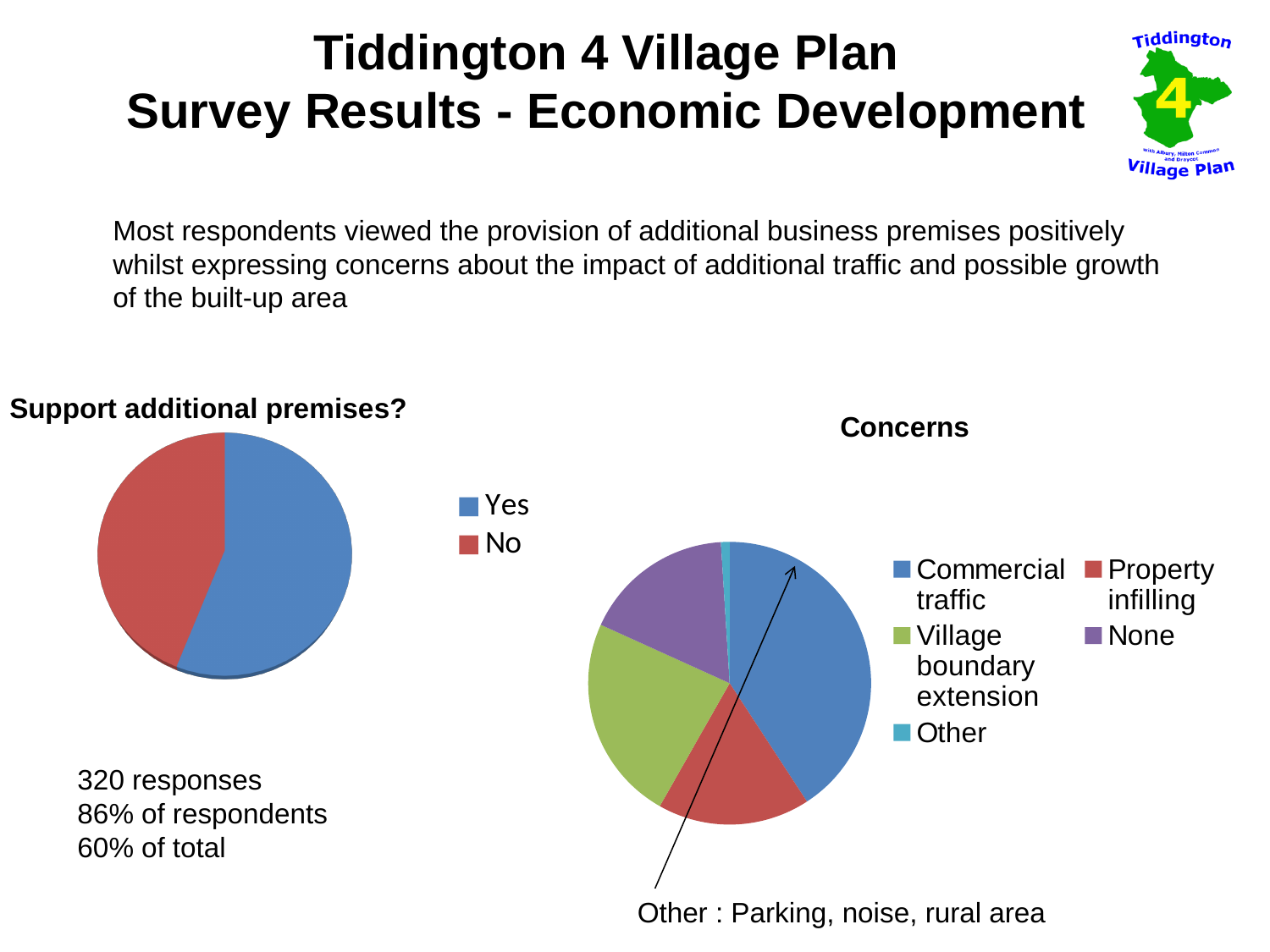
What kind of chart is the "Concerns" chart? Pie chart In the "Concerns" chart, which category has the smallest slice? Other In the "Support additional premises?" chart, is the Yes slice larger or smaller than the No slice? Larger How many entries does the legend of the "Support additional premises?" chart list? 2 In the "Concerns" chart, which slice is larger: Commercial traffic or Property infilling? Commercial traffic How many categories does the "Concerns" chart show? 5 In the "Support additional premises?" chart, which response has the larger slice? Yes In the "Concerns" chart, which slice is larger: Village boundary extension or None? Village boundary extension In the "Support additional premises?" chart, which response has the smaller slice? No What colour represents "Yes" in the "Support additional premises?" chart? Blue In the "Concerns" chart, which concern has the largest slice? Commercial traffic What kind of chart is the "Support additional premises?" chart? Pie chart